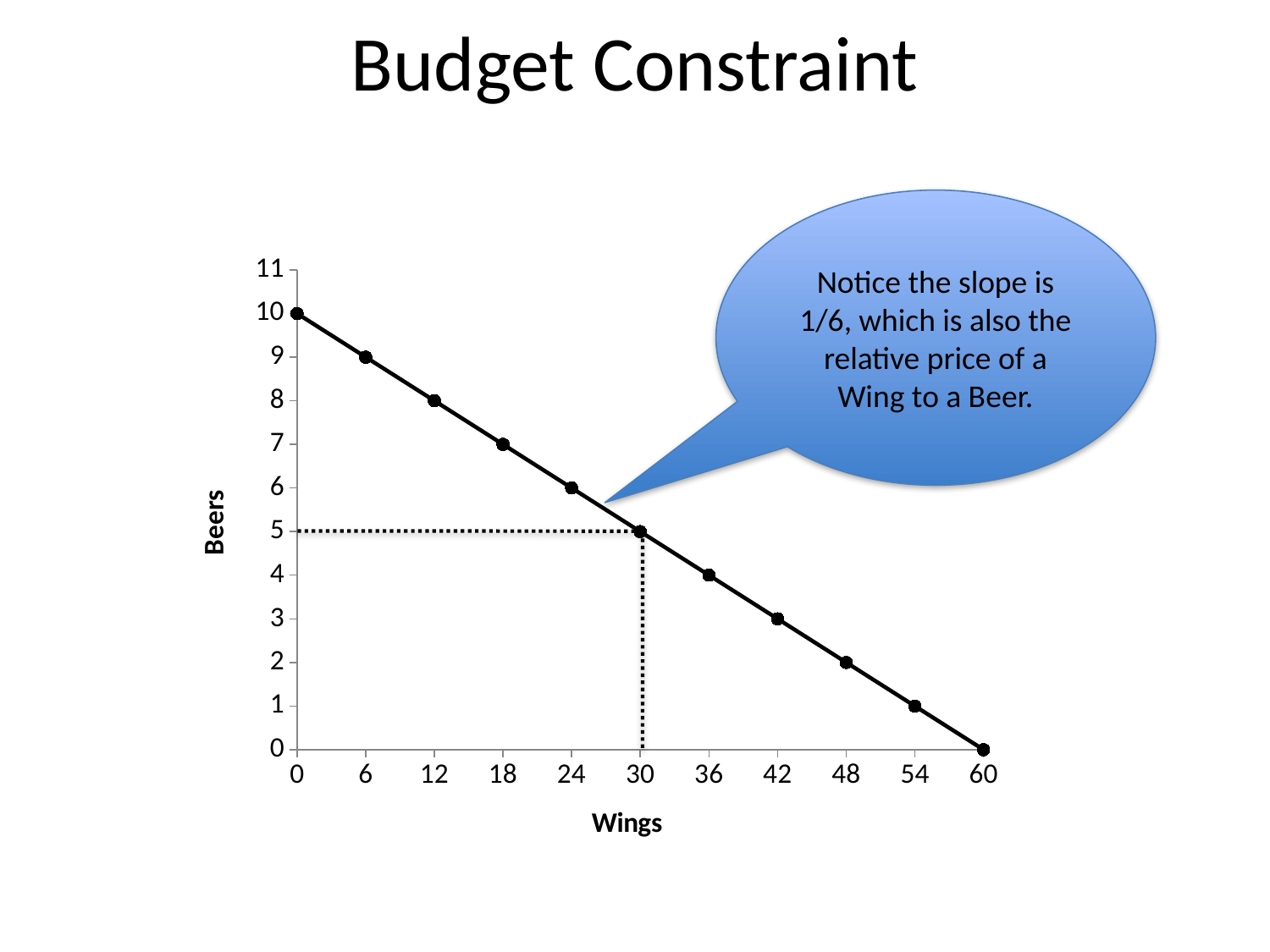
How many Beers does the line show when Wings is 0? 10 How many Beers does the line show when Wings is 60? 0 What is the difference in Beers between Wings = 0 and Wings = 30? 5 Which has more Beers: Wings = 12 or Wings = 42? Wings = 12 At which value of Wings is the number of Beers lowest? 60 How many Beers does the line show when Wings is 18? 7 What type of chart is shown on the slide? Line chart What is the title of the slide? Budget Constraint What is the label of the x axis? Wings Do the Beers values rise or fall as Wings increases along the x axis? Fall How many Beers does the line show when Wings is 30? 5 At which value of Wings is the number of Beers highest? 0